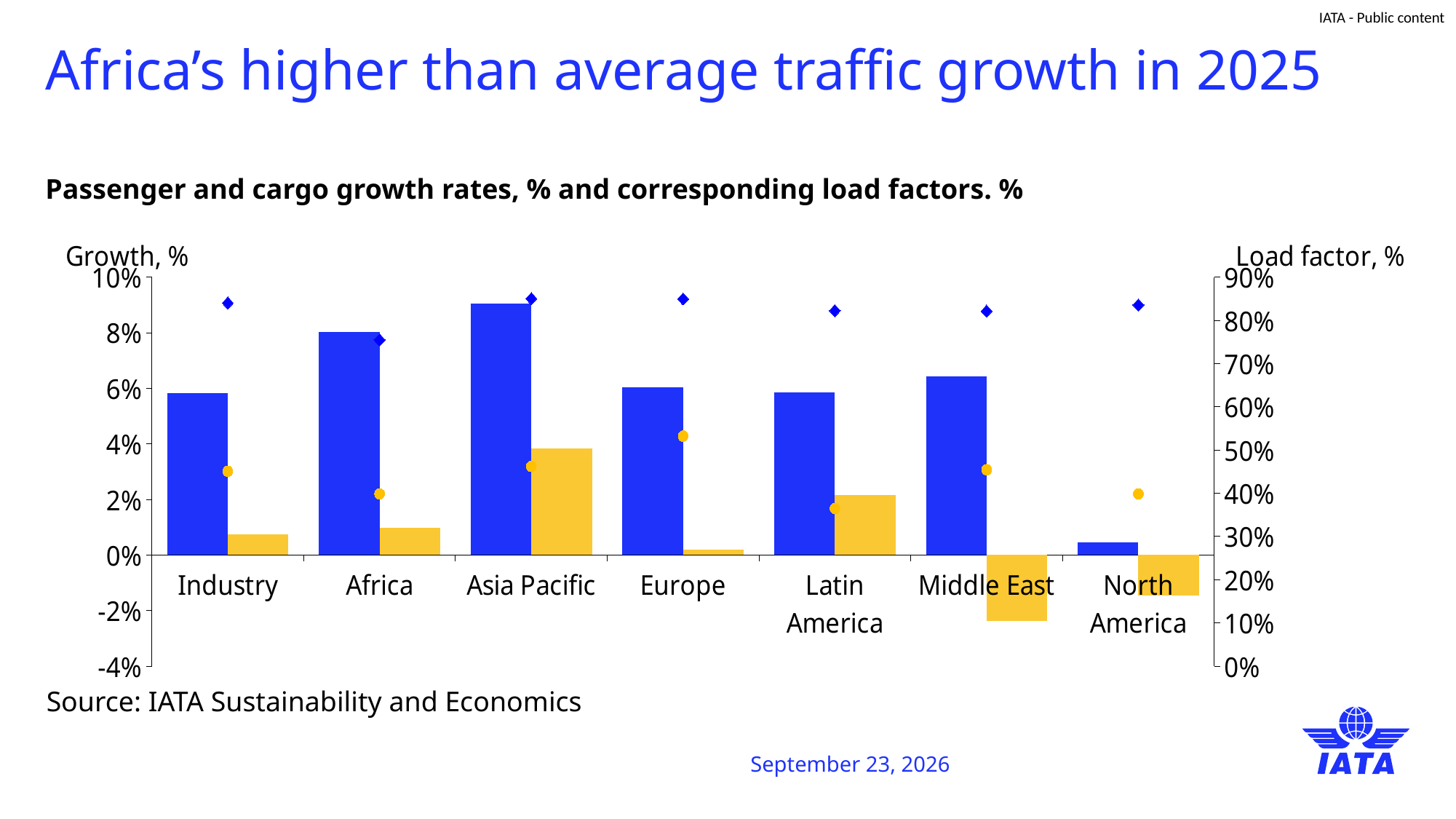
How many categories are shown along the x axis of the chart? 7 Which has the taller blue bar, Africa or Europe? Africa What kind of chart is shown on the slide? combination bar and line chart Is the yellow bar for Middle East greater or less than 0%? less What is the label of the left vertical axis of the chart? Growth, % Which category has the tallest yellow bar? Asia Pacific How many categories have a yellow bar below 0%? 2 Which category has the shortest blue bar? North America Is the blue bar for North America greater or less than 2%? less Which category has the tallest blue bar? Asia Pacific Is the blue bar for Africa greater or less than 6%? greater Which category has the lowest yellow bar? Middle East